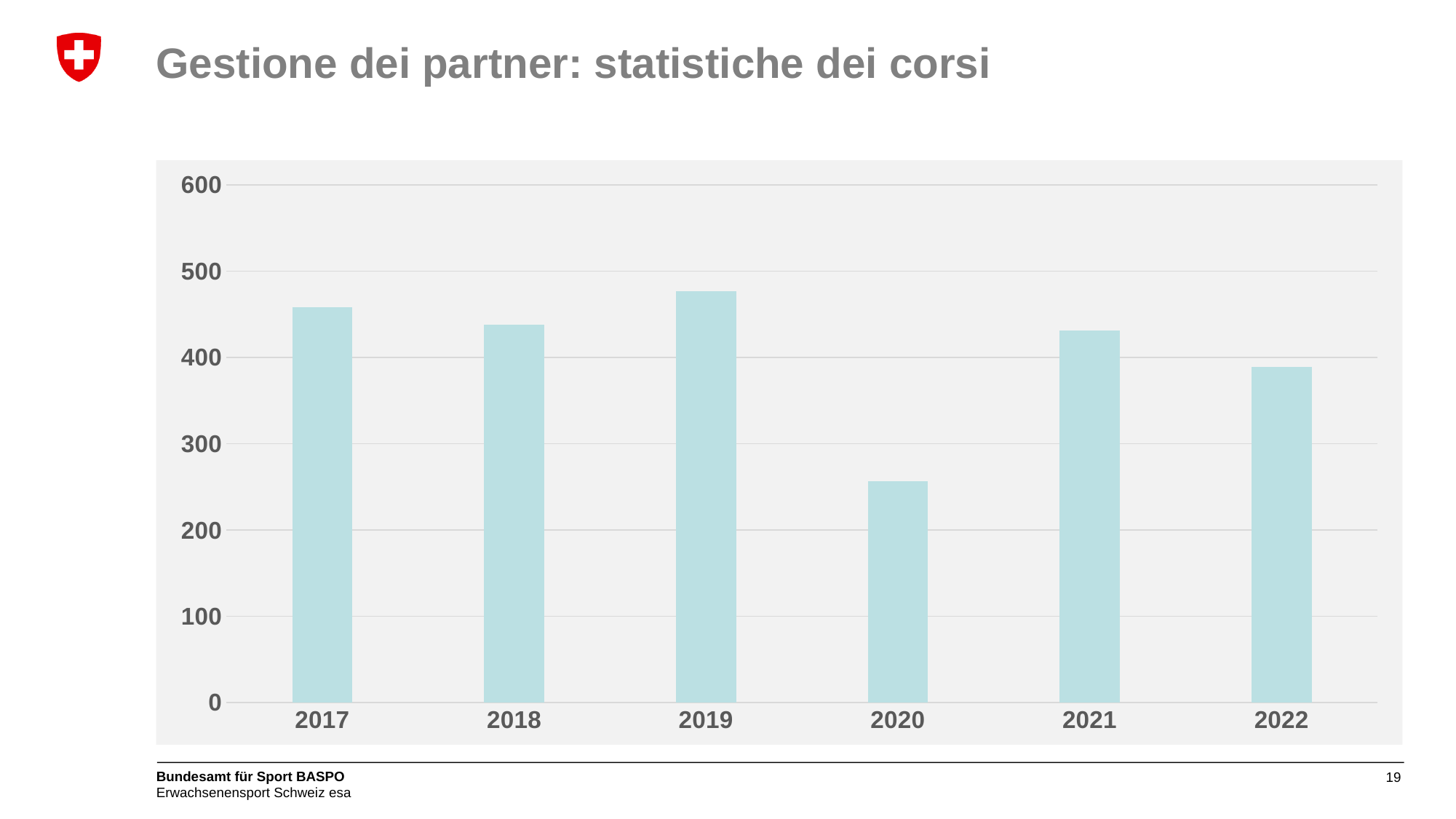
What kind of chart is shown on the slide? bar chart Which year has the lowest bar in the chart? 2020 Is the value for 2019 greater or less than 500? less How many years are shown on the x axis of the chart? 6 Does the value rise or fall from 2019 to 2020? fall Which is larger, the value for 2017 or the value for 2018? 2017 Which is larger, the value for 2021 or the value for 2022? 2021 Is the value for 2017 greater or less than 400? greater Is the value for 2022 greater or less than 400? less Which year has the highest bar in the chart? 2019 What is the title of the slide containing the chart? Gestione dei partner: statistiche dei corsi